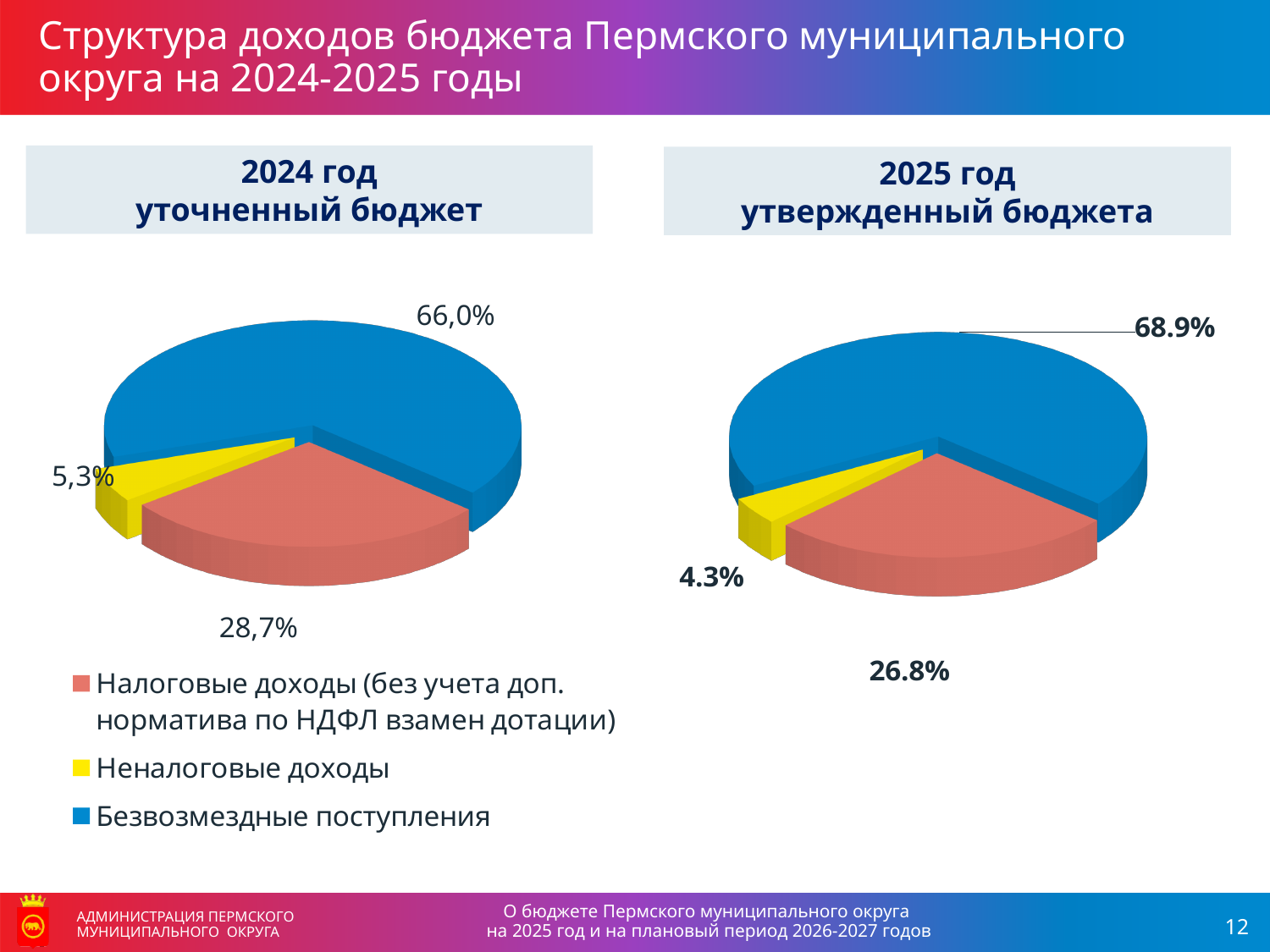
In the "2025 год утвержденный бюджета" pie chart, what share is shown for Налоговые доходы? 26.8% Which is larger: the Налоговые доходы share in the 2024 chart or in the 2025 chart? 2024 chart In the "2024 год уточненный бюджет" pie chart, what share is shown for Неналоговые доходы? 5,3% How many categories does the legend list? 3 In the "2024 год уточненный бюджет" pie chart, which category has the largest slice? Безвозмездные поступления In the "2025 год утвержденный бюджета" pie chart, what share is shown for Неналоговые доходы? 4.3% In the "2024 год уточненный бюджет" pie chart, what share is shown for Безвозмездные поступления? 66,0% What is the difference between the Безвозмездные поступления share in the 2025 chart and in the 2024 chart? 2.9 percentage points In the "2025 год утвержденный бюджета" pie chart, what share is shown for Безвозмездные поступления? 68.9% In the "2024 год уточненный бюджет" pie chart, what share is shown for Налоговые доходы? 28,7% In the "2025 год утвержденный бюджета" pie chart, which category has the smallest slice? Неналоговые доходы What type of chart is used on this slide? Pie chart